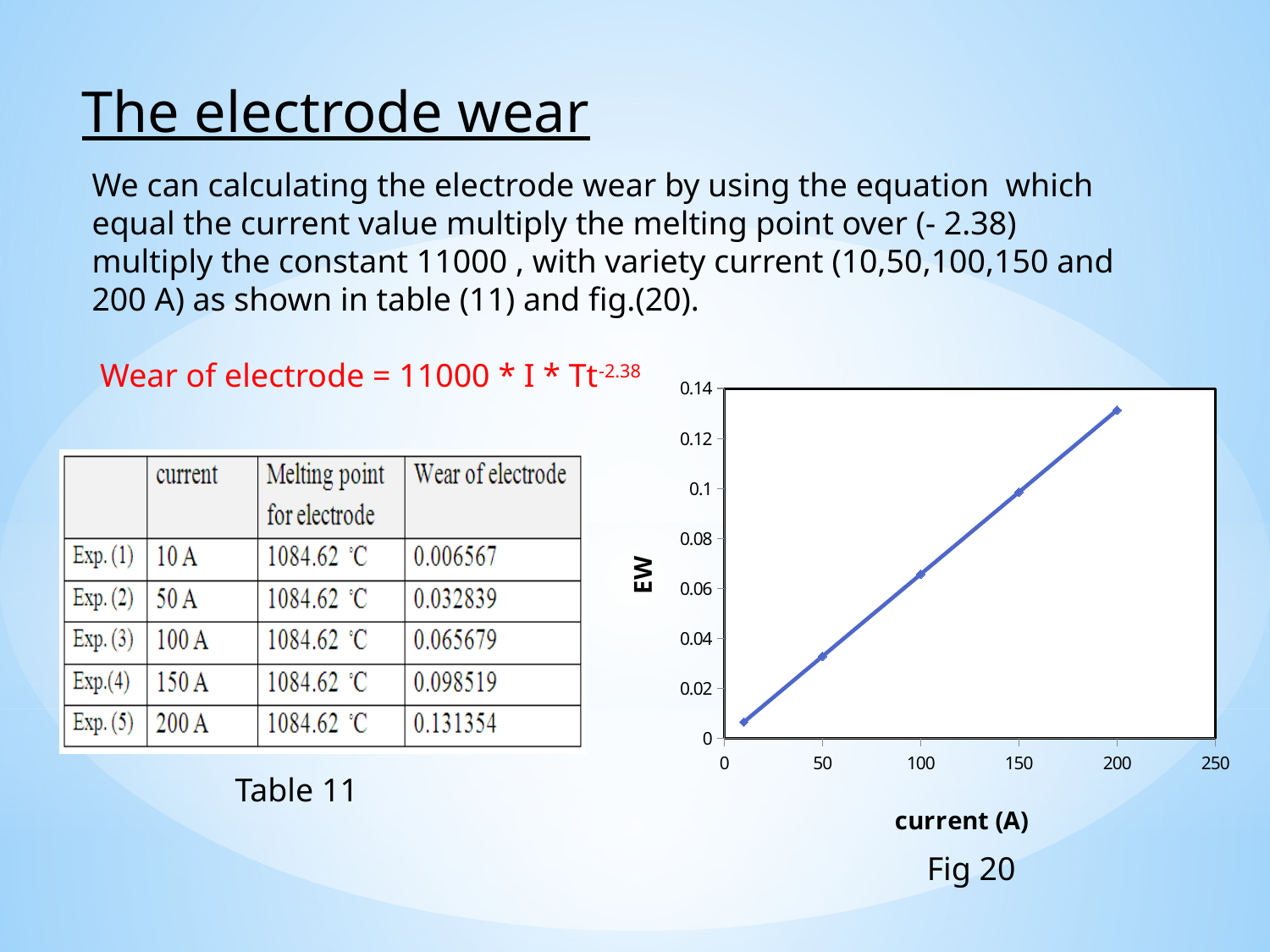
In Fig 20, is the EW value at a current of 100 A greater or less than 0.06? greater How many data points are plotted in Fig 20? 5 What is the highest tick value shown on the y axis of Fig 20? 0.14 In Fig 20, does EW rise or fall as current increases? rise What is the label of the y axis in Fig 20? EW In Fig 20, is the EW value at a current of 50 A greater or less than 0.04? less In Fig 20, is the EW value at a current of 200 A greater or less than 0.12? greater In Fig 20, at which current value is EW highest? 200 What is the label of the x axis in Fig 20? current (A) In Fig 20, which has the larger EW value: a current of 150 A or a current of 100 A? 150 A What kind of chart is Fig 20? line chart In Fig 20, at which current value is EW lowest? 10